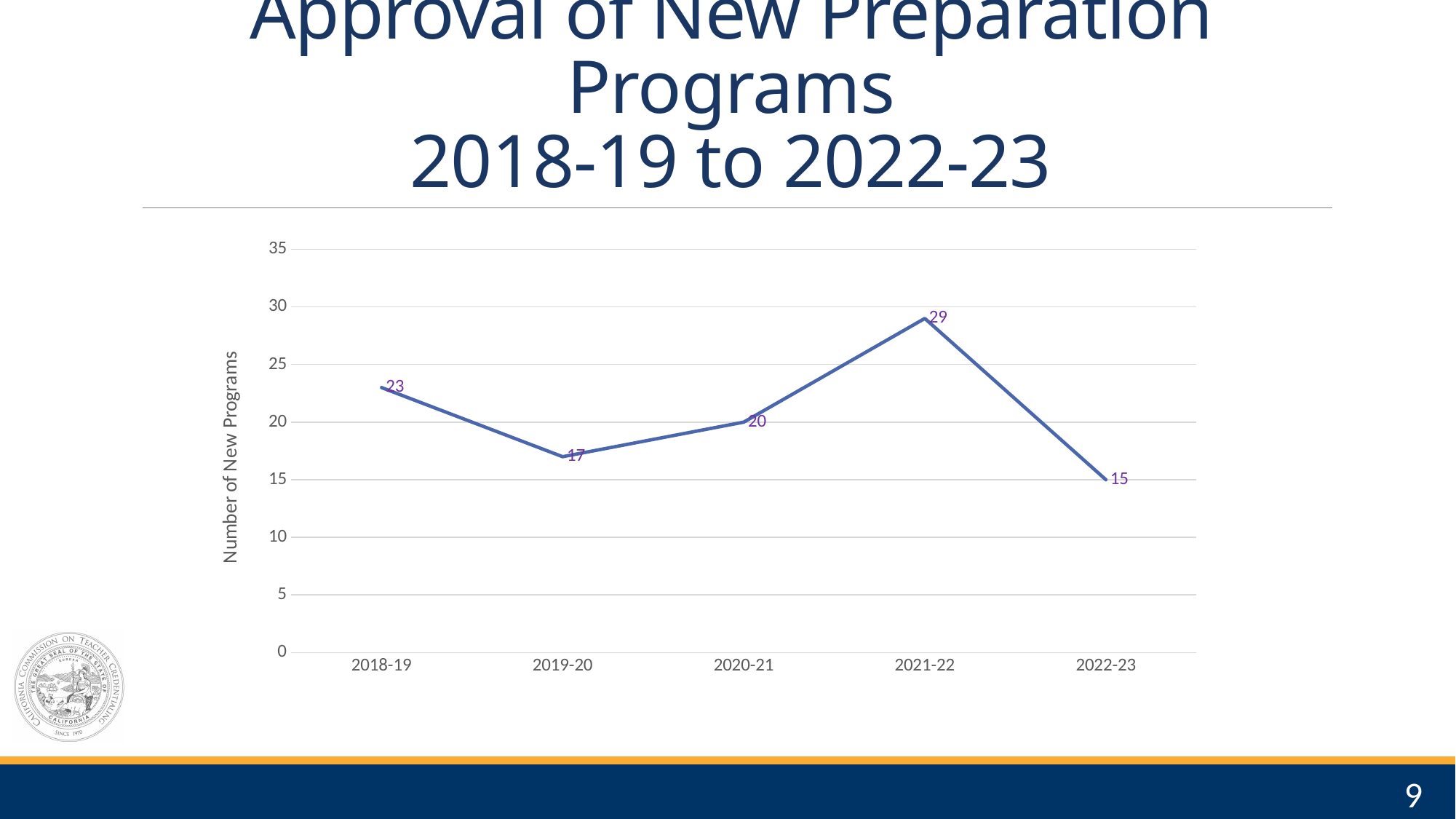
How many years are plotted on the chart? 5 Which year had more new programs approved, 2018-19 or 2020-21? 2018-19 Is the value for 2021-22 greater or less than 25? greater What is the number of new programs approved in 2022-23? 15 What is the label of the vertical axis? Number of New Programs What is the number of new programs approved in 2019-20? 17 Which year had the highest number of new programs approved? 2021-22 What kind of chart is shown on the slide? line chart What is the number of new programs approved in 2021-22? 29 What is the difference between the number of new programs in 2021-22 and 2022-23? 14 What is the number of new programs approved in 2018-19? 23 Which year had the lowest number of new programs approved? 2022-23